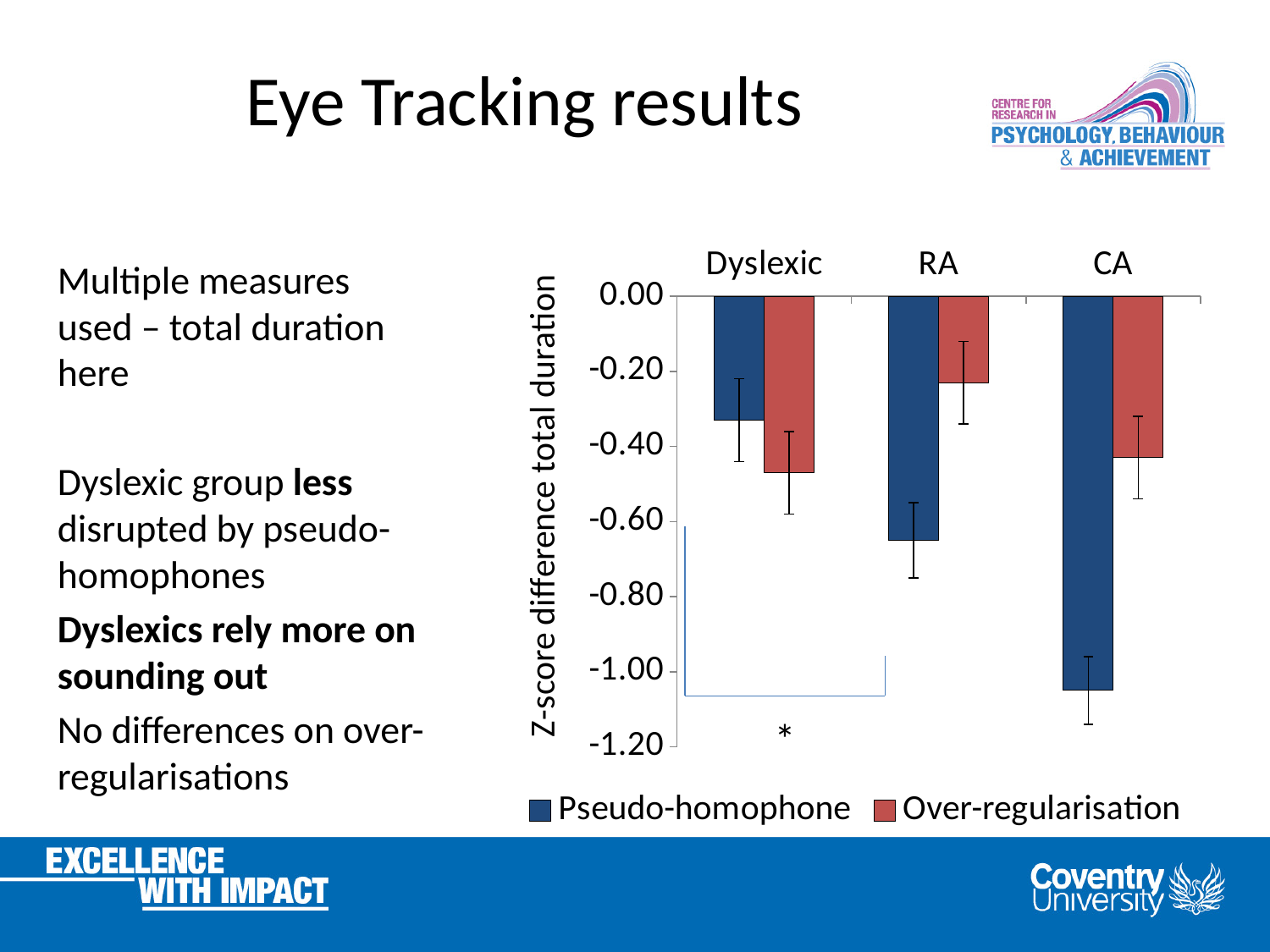
Which group has the highest (closest to zero) Over-regularisation value? RA Which group has the lowest (most negative) Pseudo-homophone value? CA How many series does the chart legend list? 2 Do the Pseudo-homophone values rise or fall moving from Dyslexic to RA to CA along the x axis? Fall Is the Pseudo-homophone value for the CA group greater or less than -1.00? less In the Dyslexic group, which series has the lower (more negative) value? Over-regularisation Which colour represents the Over-regularisation series in the chart? Red What is the title of the vertical axis of the chart? Z-score difference total duration What kind of chart is shown on the slide? Bar chart How many groups are shown along the x axis of the chart? 3 Which group has the highest (closest to zero) Pseudo-homophone value? Dyslexic In the RA group, which series has the lower (more negative) value? Pseudo-homophone